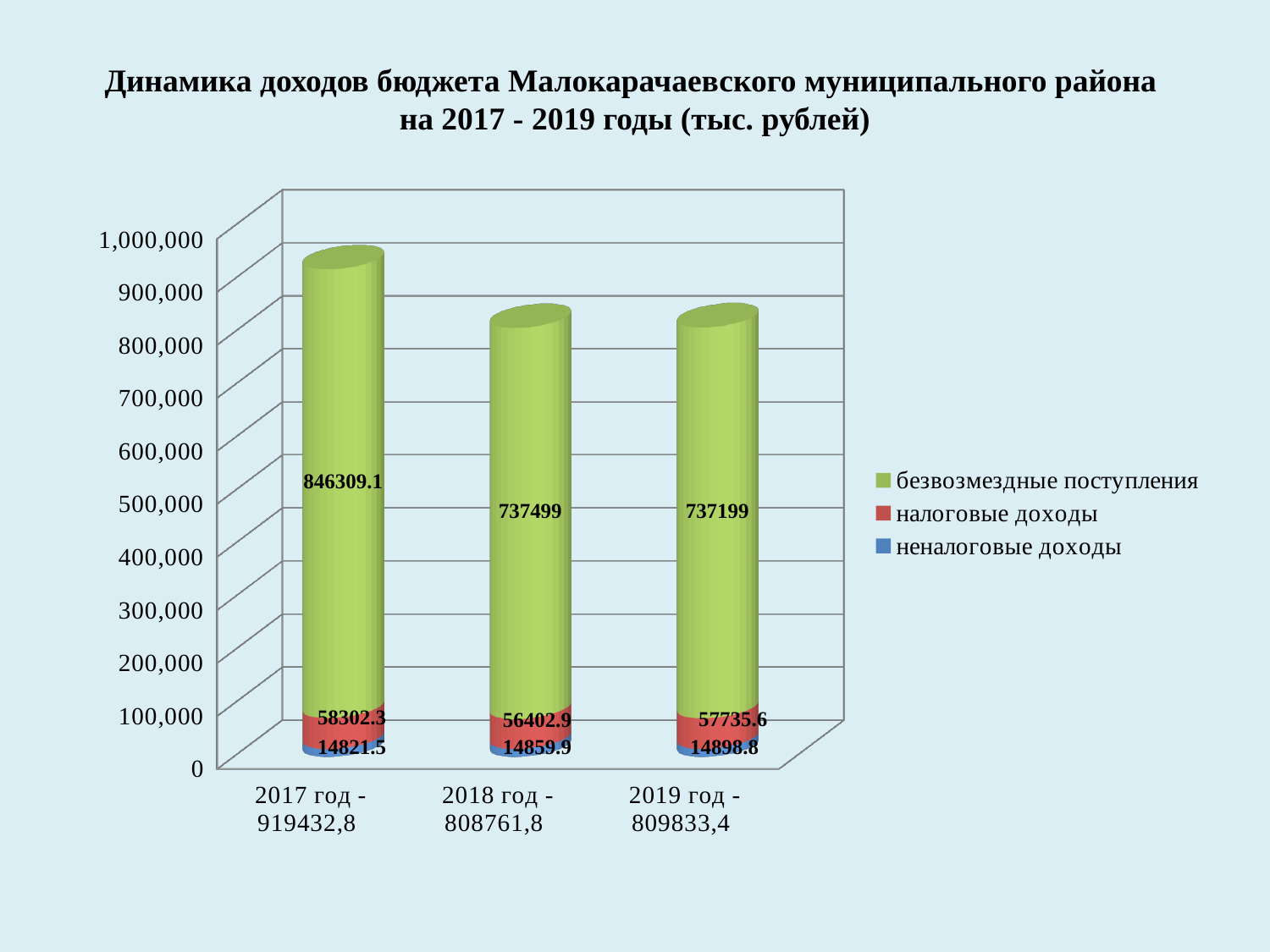
What is the value of безвозмездные поступления for 2017? 846309.1 What is the difference between налоговые доходы in 2017 and in 2018? 1899.4 What is the difference between безвозмездные поступления in 2018 and in 2019? 300 In which year is the value of налоговые доходы the lowest? 2018 How many series does the legend list? 3 In which year is the value of безвозмездные поступления the highest? 2017 What total is shown in the category label for 2019? 809833,4 Is the total height of the 2018 stacked bar greater or less than 900,000? less What is the value of неналоговые доходы for 2018? 14859.9 Which is larger: неналоговые доходы in 2019 or in 2017? 2019 What is the value of налоговые доходы for 2019? 57735.6 What kind of chart is shown on the slide? Stacked bar chart